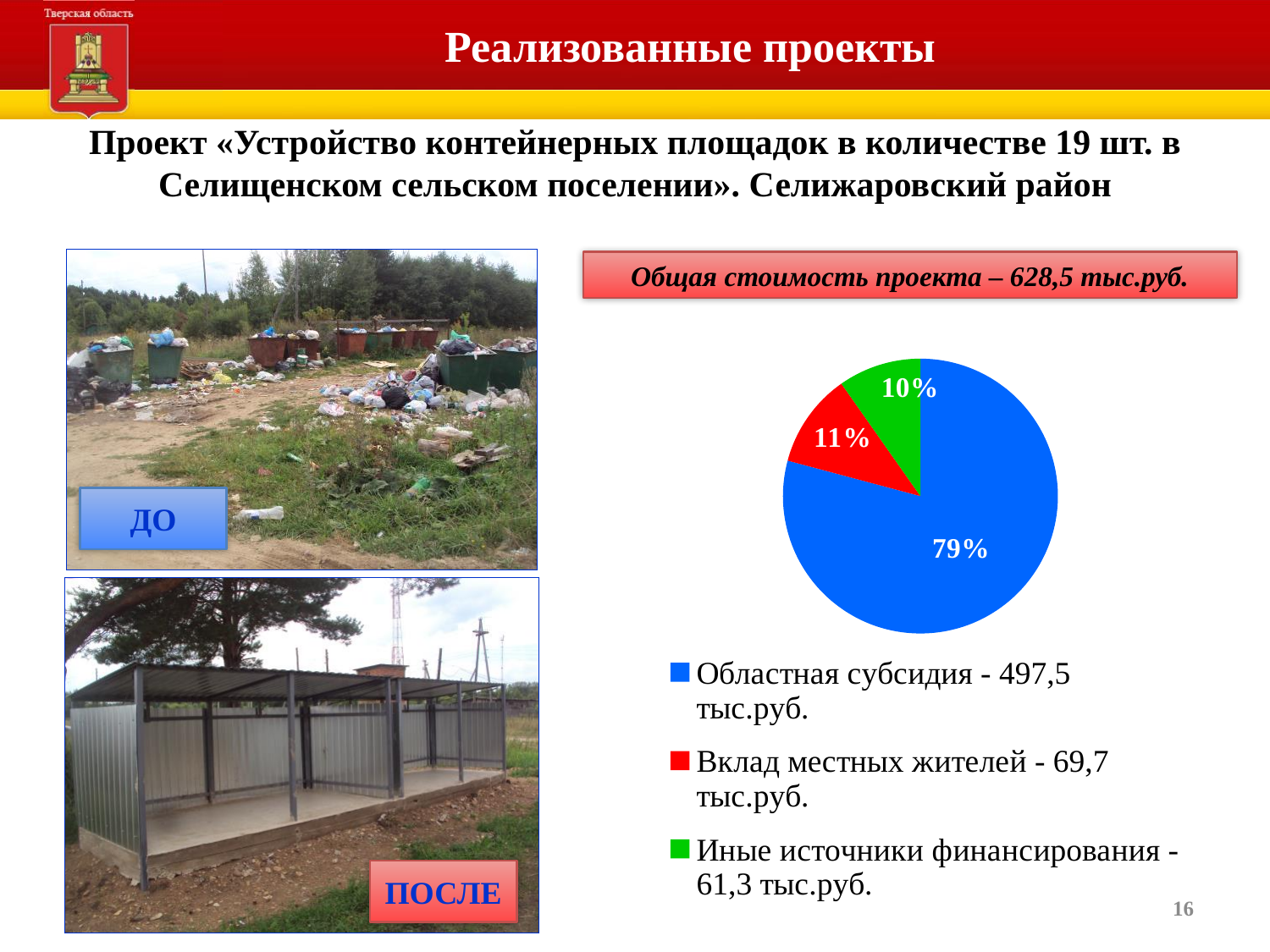
What amount is given in the legend for "Иные источники финансирования"? 61,3 тыс.руб. What colour is the slice for "Вклад местных жителей"? red How many entries does the legend of the pie chart list? 3 How many slices does the pie chart have? 3 What share of the pie does "Вклад местных жителей" take? 11% Which funding source has the smallest slice of the pie? Иные источники финансирования What share of the pie does "Областная субсидия" take? 79% What amount is given in the legend for "Вклад местных жителей"? 69,7 тыс.руб. What kind of chart is shown on the slide? pie chart What amount is given in the legend for "Областная субсидия"? 497,5 тыс.руб. Which funding source has the largest slice of the pie? Областная субсидия What share of the pie does "Иные источники финансирования" take? 10%